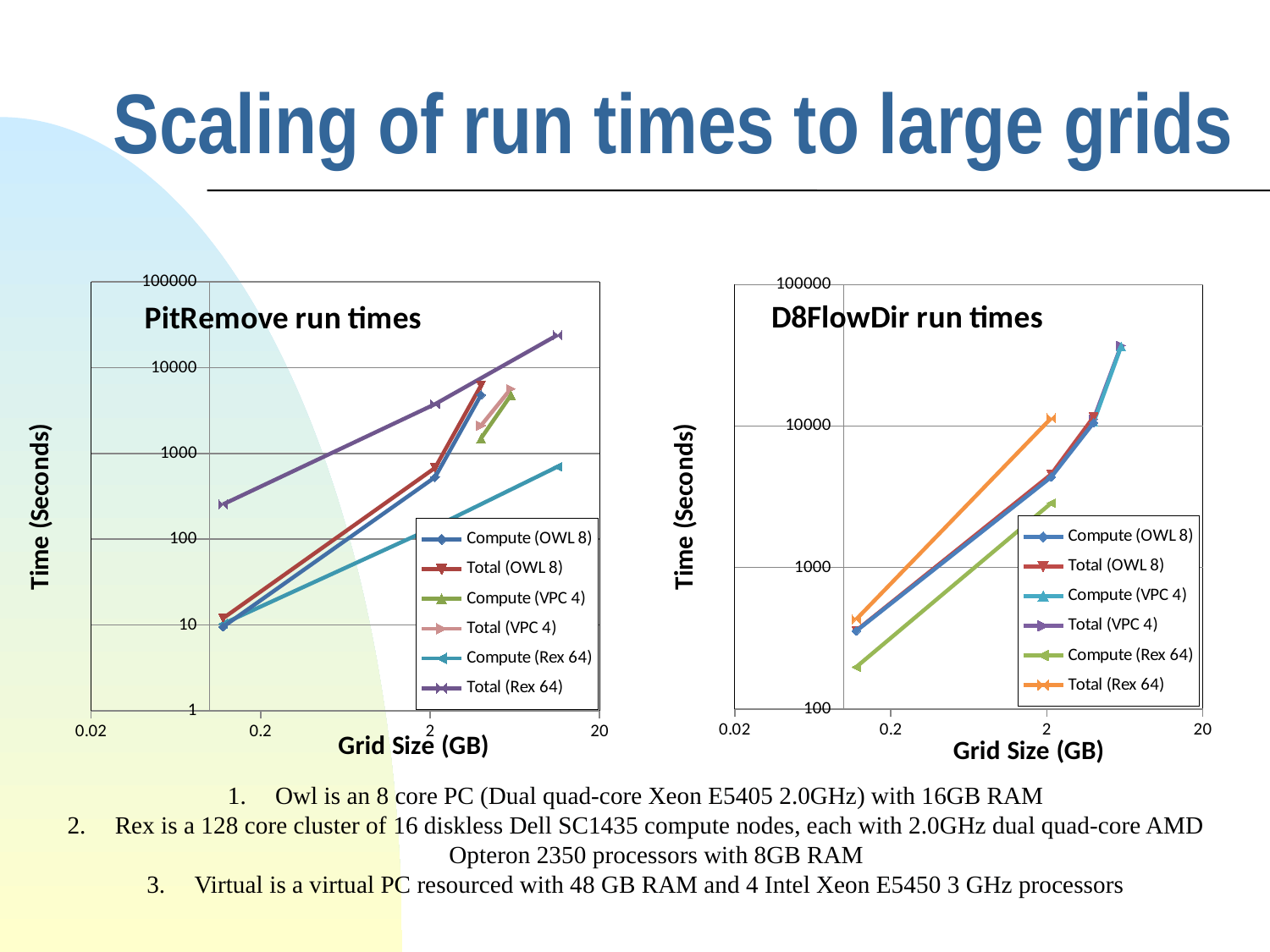
In the PitRemove run times chart, is the value for Total (Rex 64) at the smallest grid size greater or less than 100? greater In the PitRemove run times chart, what is the label of the y axis? Time (Seconds) In the D8FlowDir run times chart, what is the label of the x axis? Grid Size (GB) How many series does the legend of the PitRemove run times chart list? 6 In the PitRemove run times chart, is the value for Compute (Rex 64) at the largest grid size greater or less than 1000? less In the D8FlowDir run times chart, do the run times rise or fall as grid size increases? rise In the PitRemove run times chart, at the smallest grid size, which is larger: Total (Rex 64) or Compute (OWL 8)? Total (Rex 64) How many series does the legend of the D8FlowDir run times chart list? 6 What kind of chart is the PitRemove run times chart? line chart In the D8FlowDir run times chart, is the value for Compute (Rex 64) at the smallest grid size greater or less than 1000? less In the PitRemove run times chart, do the run times rise or fall as grid size increases? rise